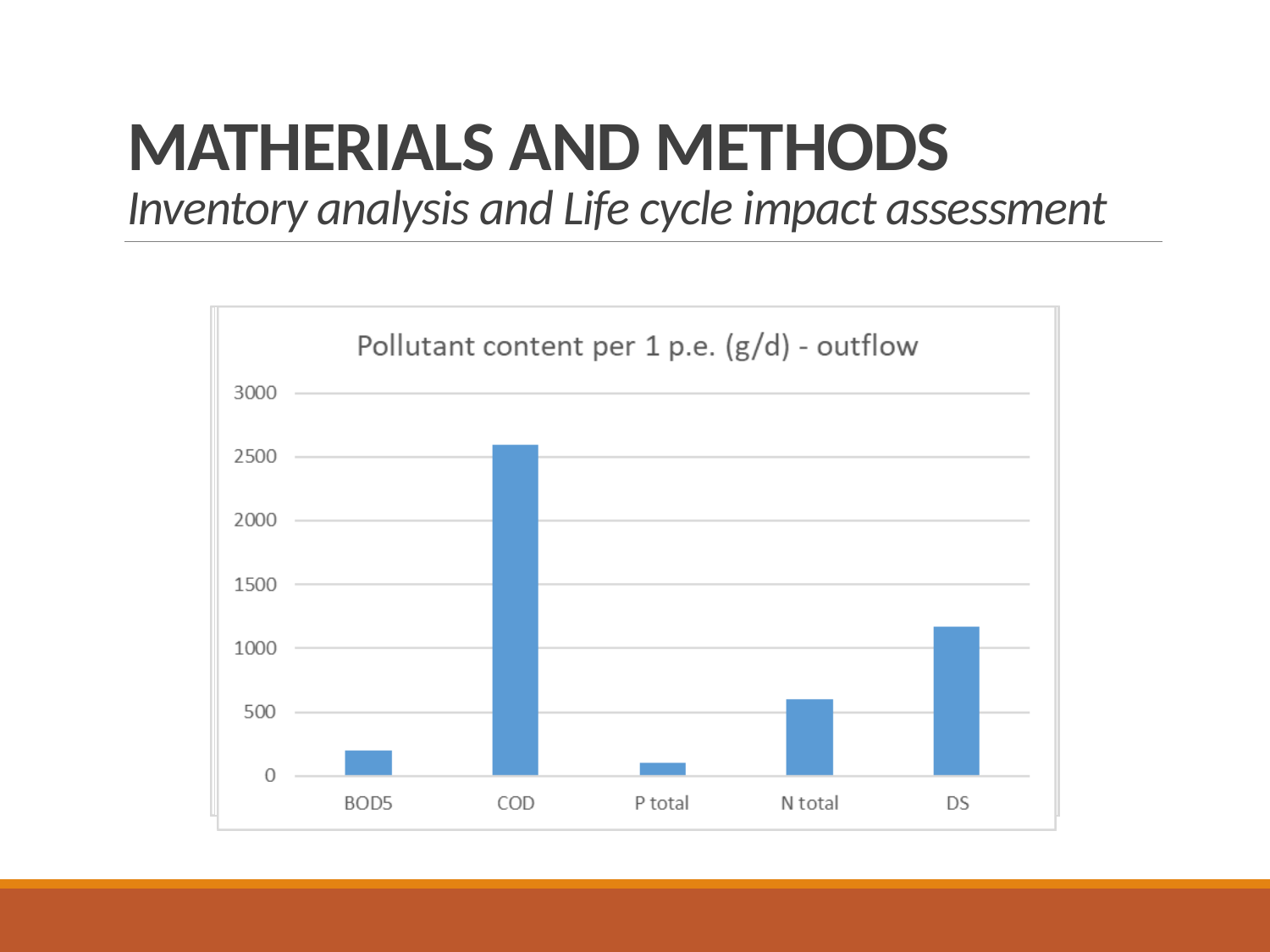
Which is larger, the value for BOD5 or the value for P total? BOD5 Is the value for DS greater or less than 1000? greater What kind of chart is shown on the slide? bar chart What is the title of the chart? Pollutant content per 1 p.e. (g/d) - outflow Which is larger, the value for DS or the value for N total? DS How many categories are plotted on the x axis of the chart? 5 Which category has the lowest value in the chart? P total Is the value for COD greater or less than 2500? greater Is the value for N total greater or less than 500? greater Which category has the highest value in the chart? COD